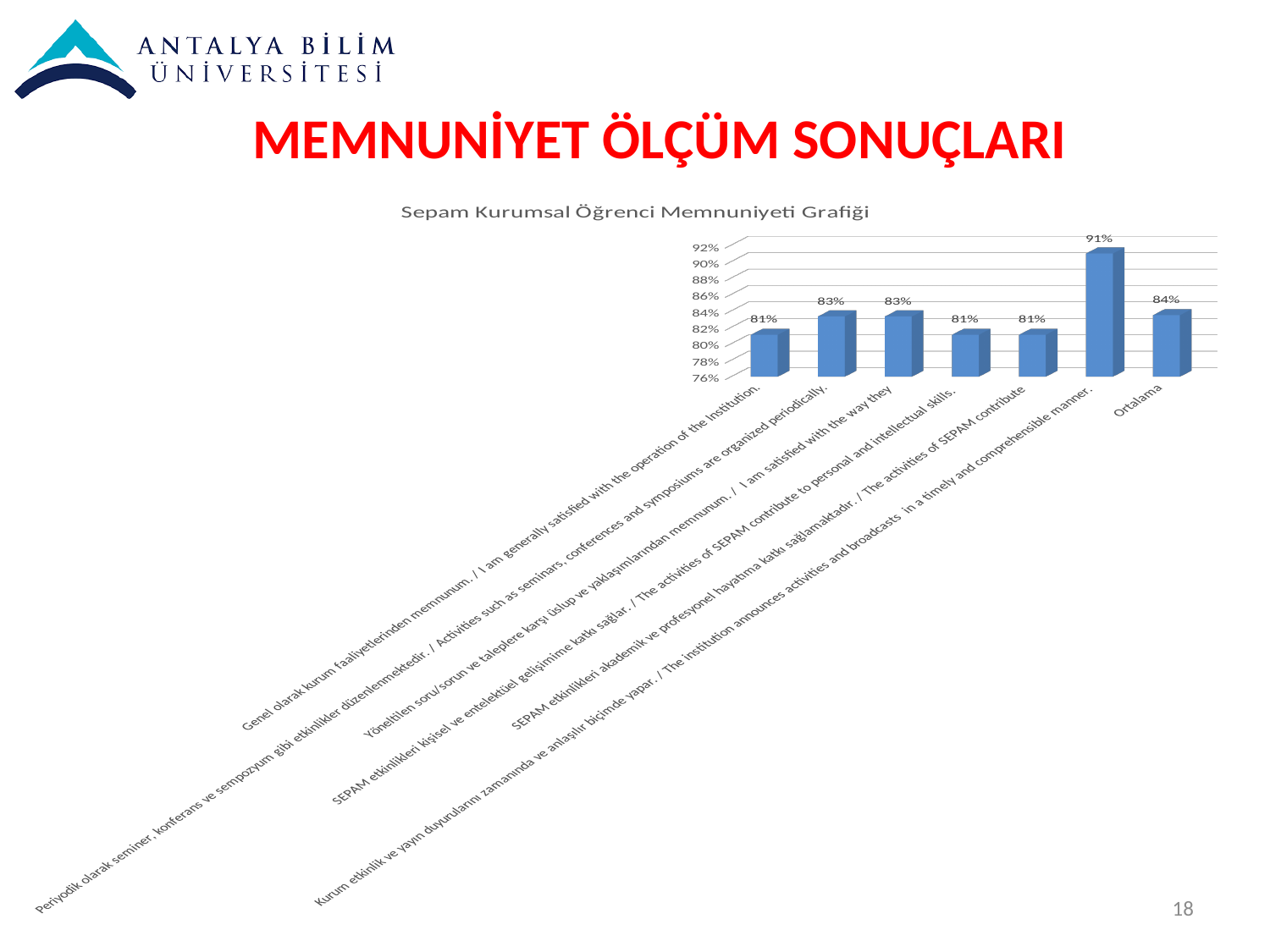
What is the value of the first bar (Genel olarak kurum faaliyetlerinden memnunum)? 81% What is the lowest value printed on the vertical axis? 76% What is the difference between the highest bar (91%) and the Ortalama bar? 7 percentage points What kind of chart is shown on the slide? bar chart What is the value of the Ortalama bar? 84% How many bars are plotted in the chart? 7 Which is larger: the Ortalama bar or the first bar (Genel olarak kurum faaliyetlerinden memnunum)? Ortalama Which category has the highest value in the chart? Kurum etkinlik ve yayın duyurularını zamanında ve anlaşılır biçimde yapar Is the value of the Ortalama bar greater or less than 80%? greater What is the highest value shown in the chart? 91% What is the title of the chart? Sepam Kurumsal Öğrenci Memnuniyeti Grafiği What is the value of the second bar (Periyodik olarak seminer, konferans ve sempozyum gibi etkinlikler düzenlenmektedir)? 83%